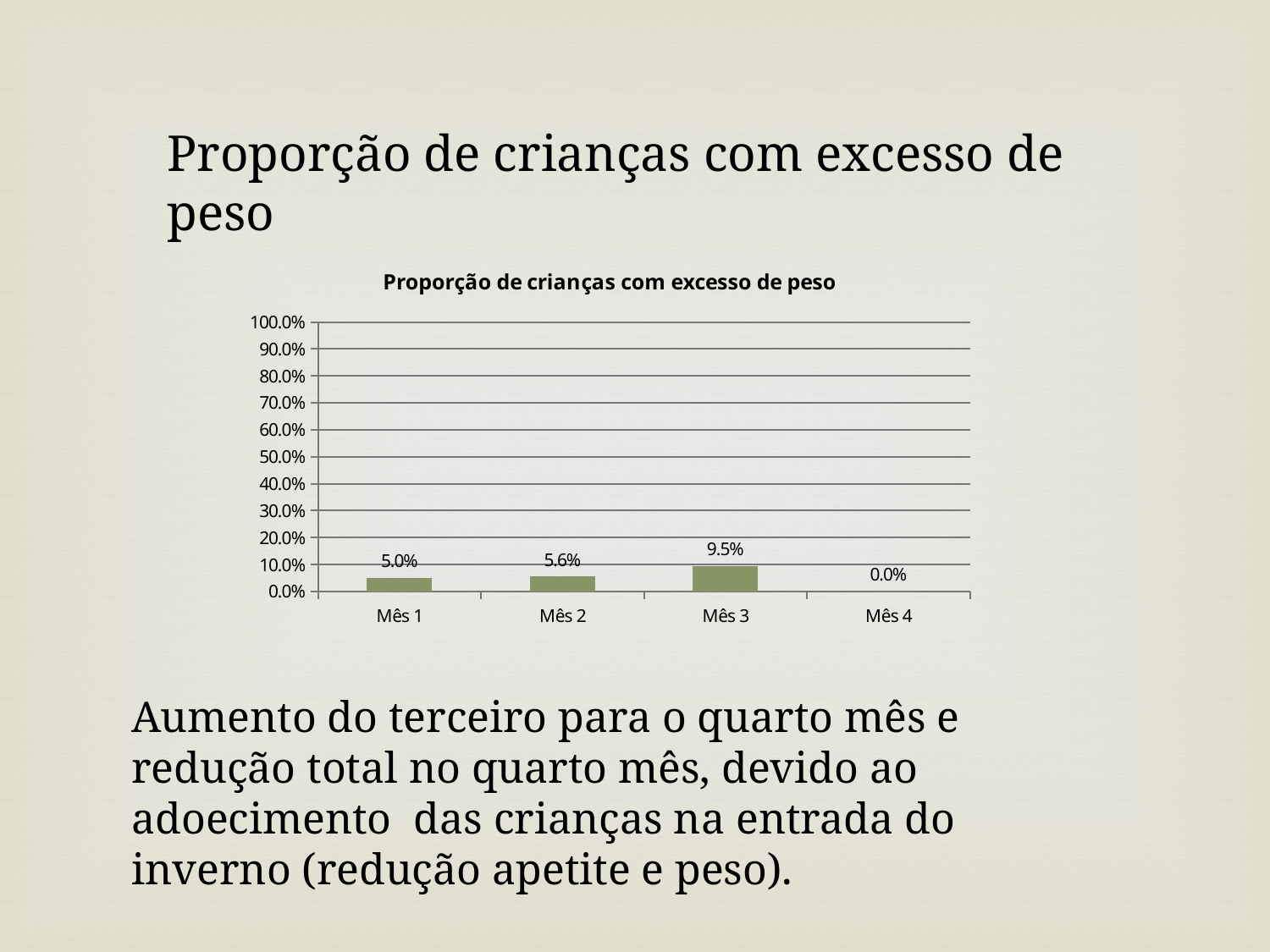
How many months are shown on the x axis? 4 What is the difference between the values for Mês 3 and Mês 1? 4.5% Which month has the lowest proportion of children with excess weight? Mês 4 What is the value for Mês 1? 5.0% What kind of chart is shown on the slide? bar chart What is the title of the chart? Proporção de crianças com excesso de peso Is the value for Mês 3 greater or less than 20.0%? less Which is larger, the value for Mês 2 or the value for Mês 3? Mês 3 What is the value for Mês 3? 9.5% What is the value for Mês 4? 0.0% Which month has the highest proportion of children with excess weight? Mês 3 What is the value for Mês 2? 5.6%